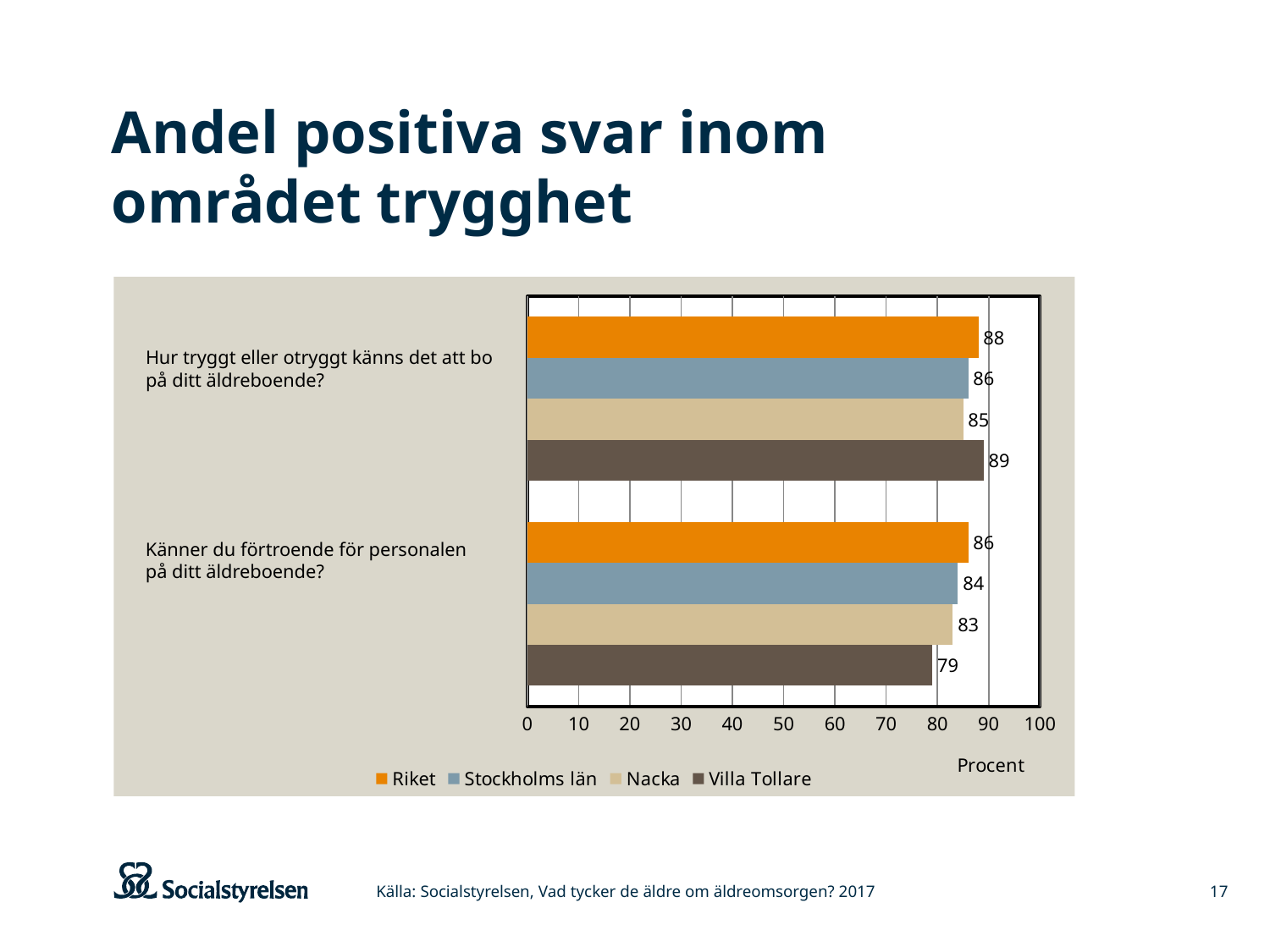
Which series has the highest value on the question "Hur tryggt eller otryggt känns det att bo på ditt äldreboende?"? Villa Tollare What is the value for Villa Tollare on the question "Känner du förtroende för personalen på ditt äldreboende?"? 79 Which series has the lowest value on the question "Känner du förtroende för personalen på ditt äldreboende?"? Villa Tollare Which is larger: the Villa Tollare value for "Hur tryggt eller otryggt känns det att bo på ditt äldreboende?" or the Villa Tollare value for "Känner du förtroende för personalen på ditt äldreboende?"? Hur tryggt eller otryggt känns det att bo på ditt äldreboende? What is the value for Nacka on the question "Hur tryggt eller otryggt känns det att bo på ditt äldreboende?"? 85 What is the value for Stockholms län on the question "Känner du förtroende för personalen på ditt äldreboende?"? 84 How many questions (categories) are shown on the chart? 2 What kind of chart is shown on the slide? Bar chart What is the value for Riket on the question "Hur tryggt eller otryggt känns det att bo på ditt äldreboende?"? 88 What unit is shown on the x axis of the chart? Procent How many series does the legend list? 4 What is the difference between the Riket value and the Villa Tollare value on the question "Känner du förtroende för personalen på ditt äldreboende?"? 7